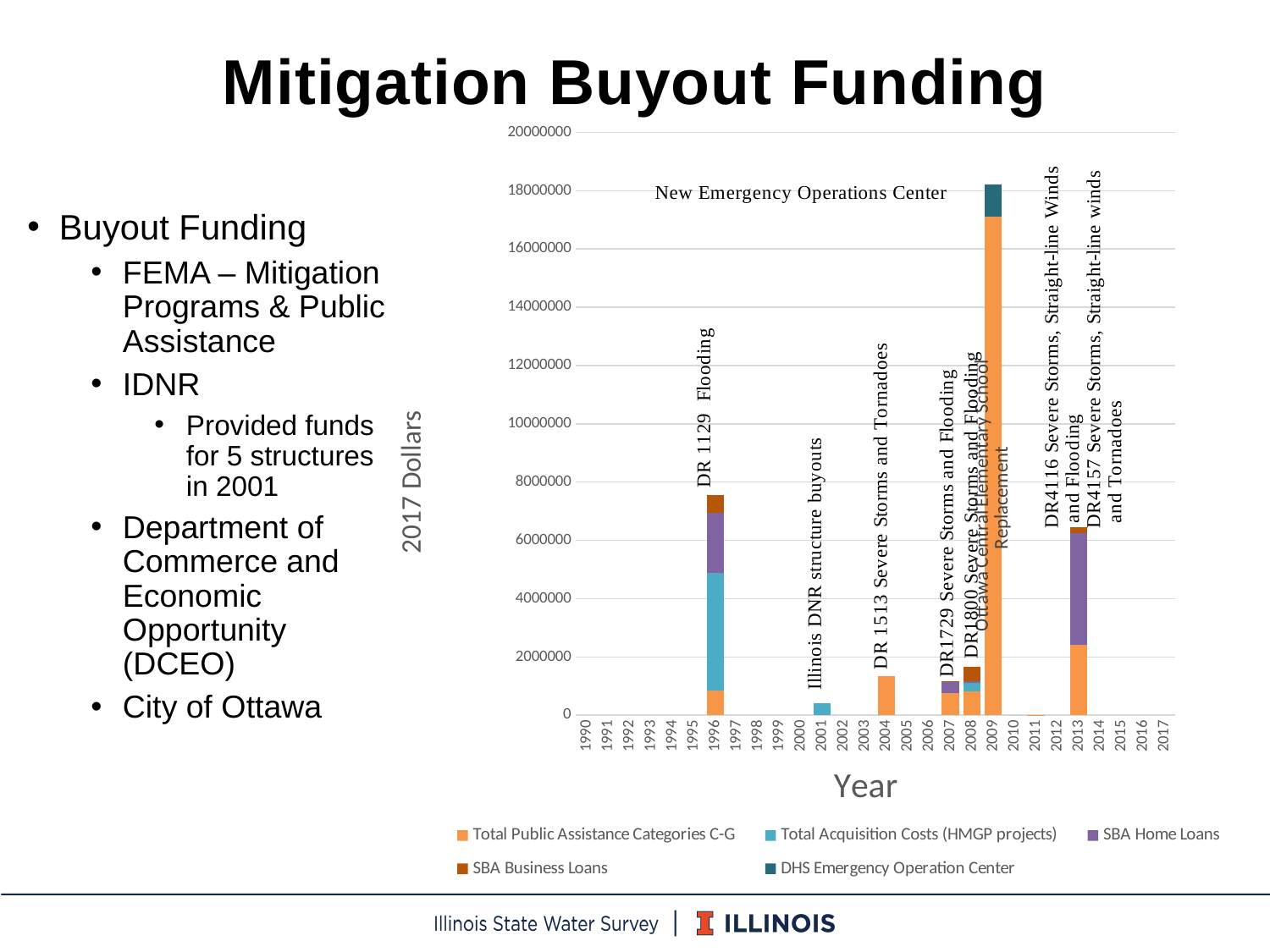
Which series does the bar for 2001 belong to, according to the legend colours? Total Acquisition Costs (HMGP projects) Which year has the larger bar, 2004 or 2001? 2004 Which year has the tallest stacked bar in the chart? 2009 Is the total value of the stacked bar for 2013 greater or less than 4000000? greater Is the total value of the stacked bar for 2009 greater or less than 16000000? greater Which year has the larger stacked bar, 2009 or 1996? 2009 Is the total value of the stacked bar for 1996 greater or less than 6000000? greater What kind of chart is shown on the slide? bar chart How many years are shown along the x axis of the chart? 28 What is the title of the y axis of the chart? 2017 Dollars How many series does the chart legend list? 5